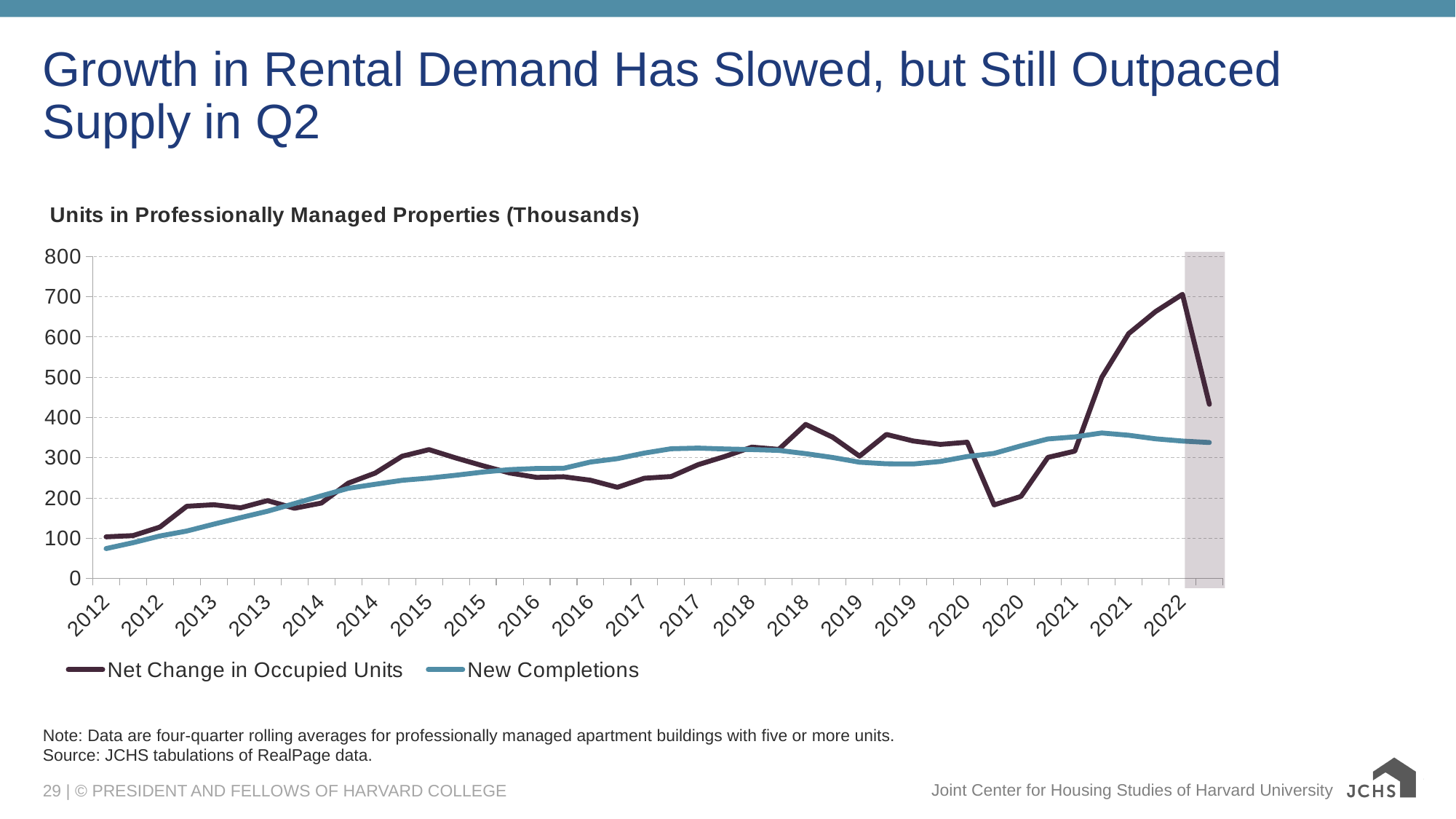
Does the New Completions line generally rise or fall from 2012 to 2022? Rise What kind of chart is shown on the slide? Line chart Is the final value of Net Change in Occupied Units (at the right end of the chart) greater or less than 400? greater Is the peak value of Net Change in Occupied Units greater or less than 600? greater What is the highest value shown on the vertical axis? 800 Is the value of New Completions at the first 2012 point greater or less than 100? less What are the two series named in the legend? Net Change in Occupied Units and New Completions How many series does the legend list? 2 Which series reaches the highest value anywhere on the chart? Net Change in Occupied Units At the dip in 2020, which series has the higher value: Net Change in Occupied Units or New Completions? New Completions At the right end of the chart, which series has the higher value: Net Change in Occupied Units or New Completions? Net Change in Occupied Units